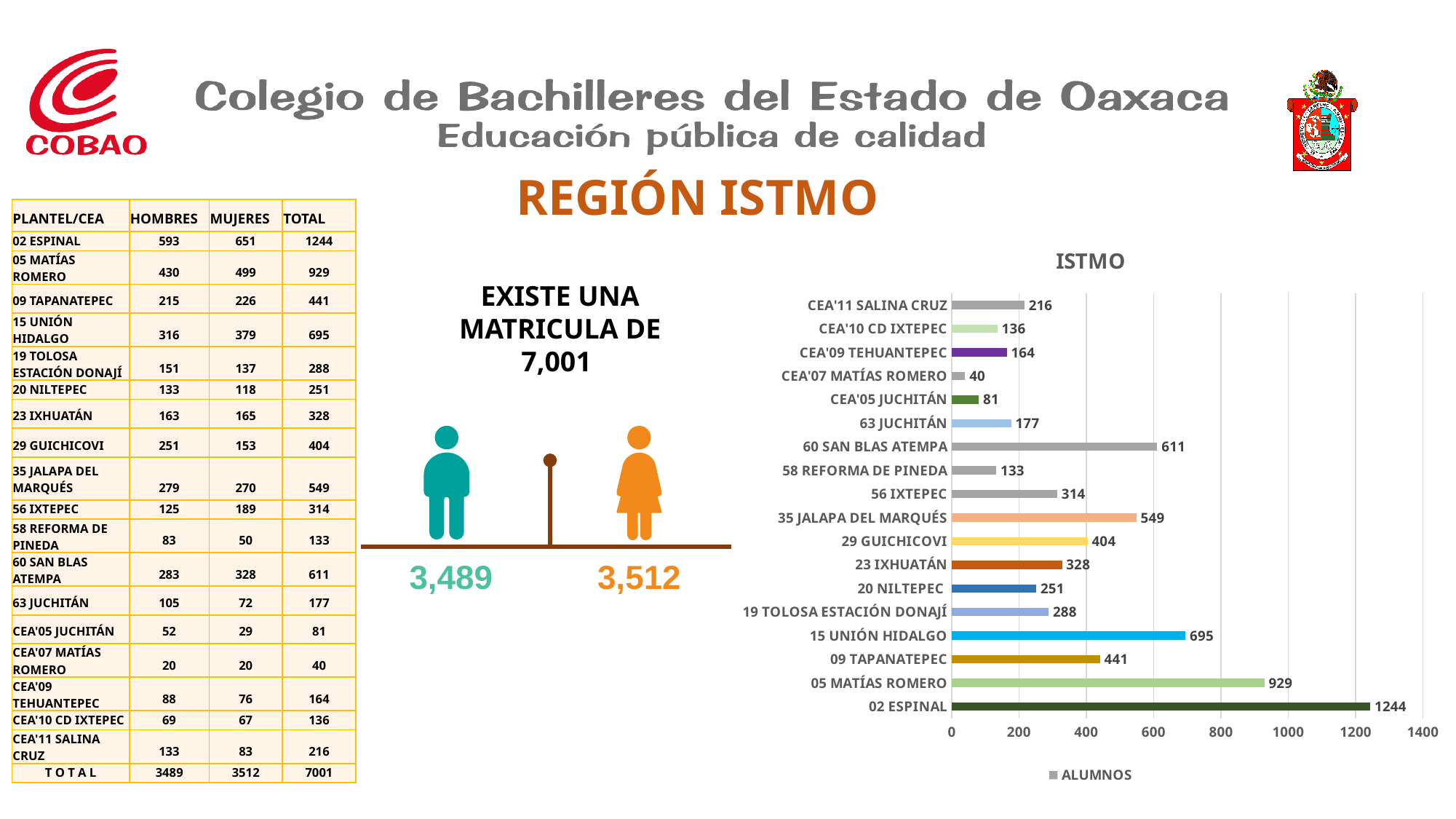
In the ISTMO chart, what is the value for 02 ESPINAL? 1244 In the ISTMO chart, what is the value for 60 SAN BLAS ATEMPA? 611 How many series does the legend of the ISTMO chart list? 1 What type of chart is the ISTMO chart? bar chart How many categories are shown in the ISTMO chart? 18 Which category has the highest value in the ISTMO chart? 02 ESPINAL Which category has the lowest value in the ISTMO chart? CEA'07 MATÍAS ROMERO In the ISTMO chart, what is the value for CEA'09 TEHUANTEPEC? 164 In the ISTMO chart, is the value for 09 TAPANATEPEC greater or less than 400? greater In the ISTMO chart, what is the difference between the values for 05 MATÍAS ROMERO and 15 UNIÓN HIDALGO? 234 What is the legend entry shown below the ISTMO chart? ALUMNOS In the ISTMO chart, which is larger: the value for 29 GUICHICOVI or the value for 23 IXHUATÁN? 29 GUICHICOVI